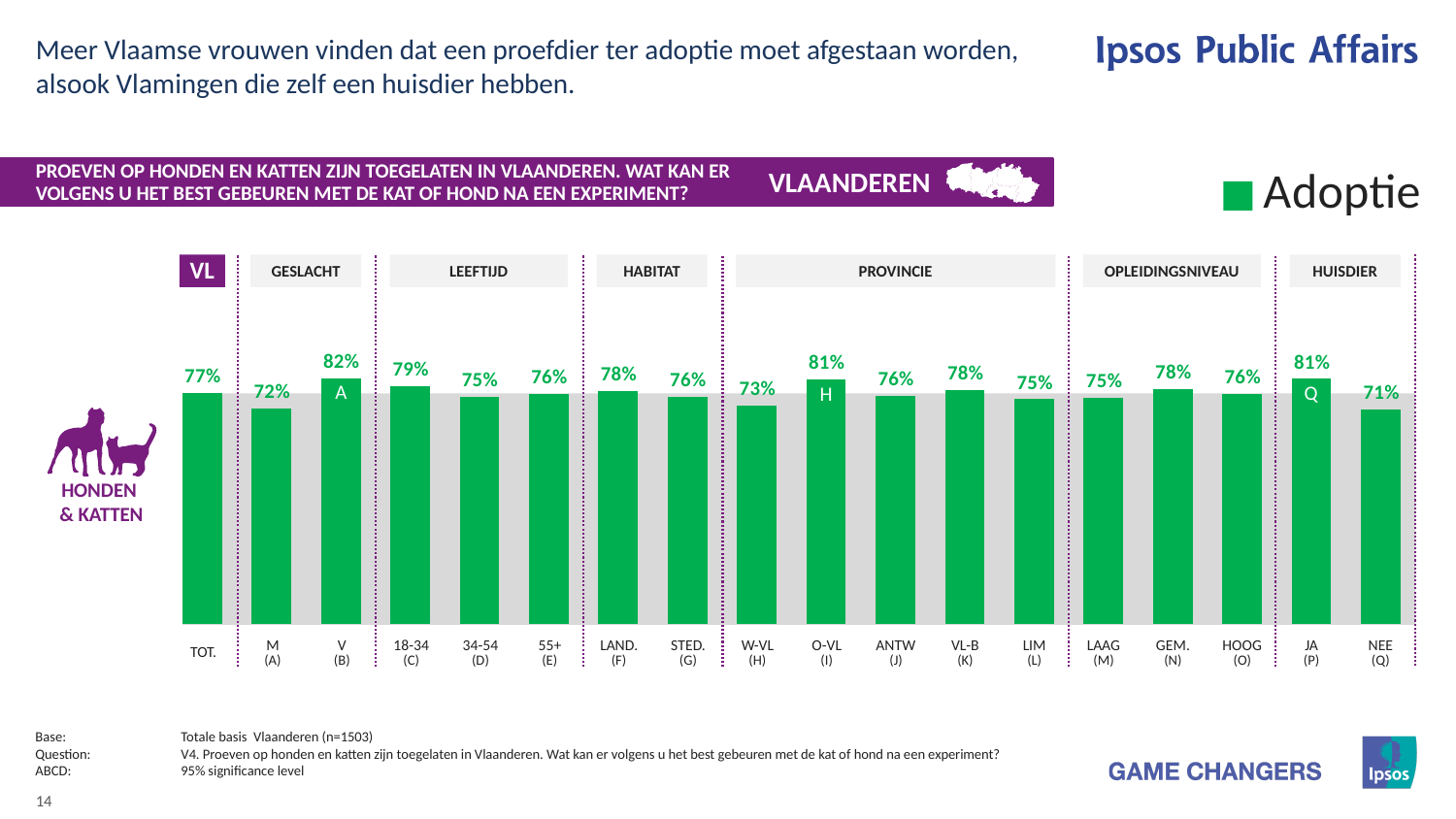
What is the value for TOT. (total Flanders) in the chart? 77% What percentage of women (V) chose 'Adoptie'? 82% Which category has the lowest value in the chart? NEE (71%) Which is larger, the value for LAND. or the value for STED.? LAND. What is the value for O-VL in the PROVINCIE section? 81% Which category has the highest value in the chart? V (82%) How many bars are plotted in the chart? 18 What is the value for the 18-34 age group? 79% What is the difference between JA and NEE under HUISDIER? 10 percentage points What is the difference between the values for V and M under GESLACHT? 10 percentage points What is the name of the series shown in the legend? Adoptie What type of chart is shown on the slide? Bar chart